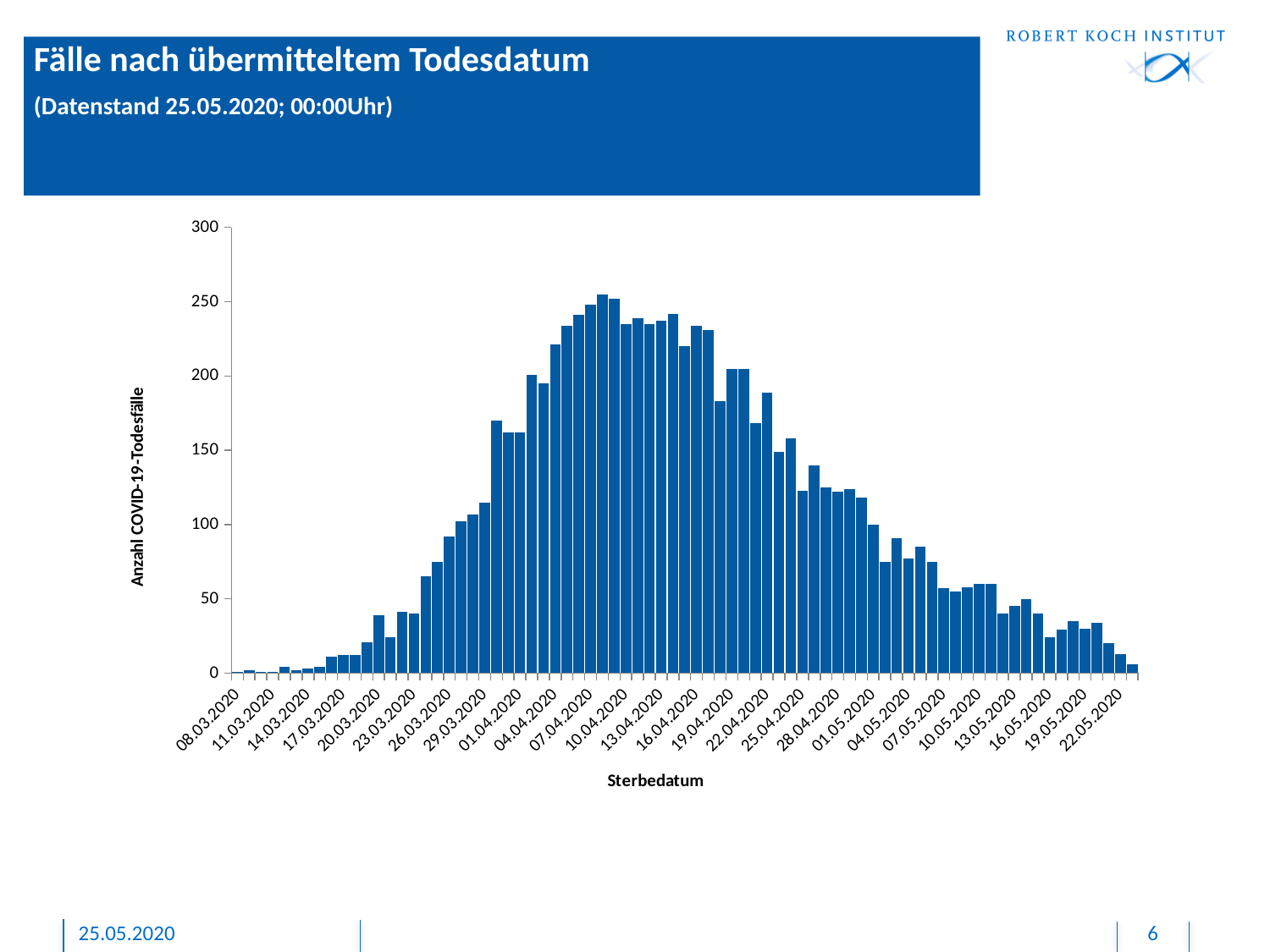
Is the value for 13.04.2020 greater or less than 200? greater Is the value for 22.05.2020 greater or less than 50? less Is the value for 28.04.2020 greater or less than 100? greater What is the title of the chart on the slide? Fälle nach übermitteltem Todesdatum Do the values rise or fall along the x axis from 10.04.2020 to 22.05.2020? fall What is the label of the x axis? Sterbedatum Which is larger, the value for 07.04.2020 or the value for 22.05.2020? 07.04.2020 What kind of chart is shown on the slide? bar chart